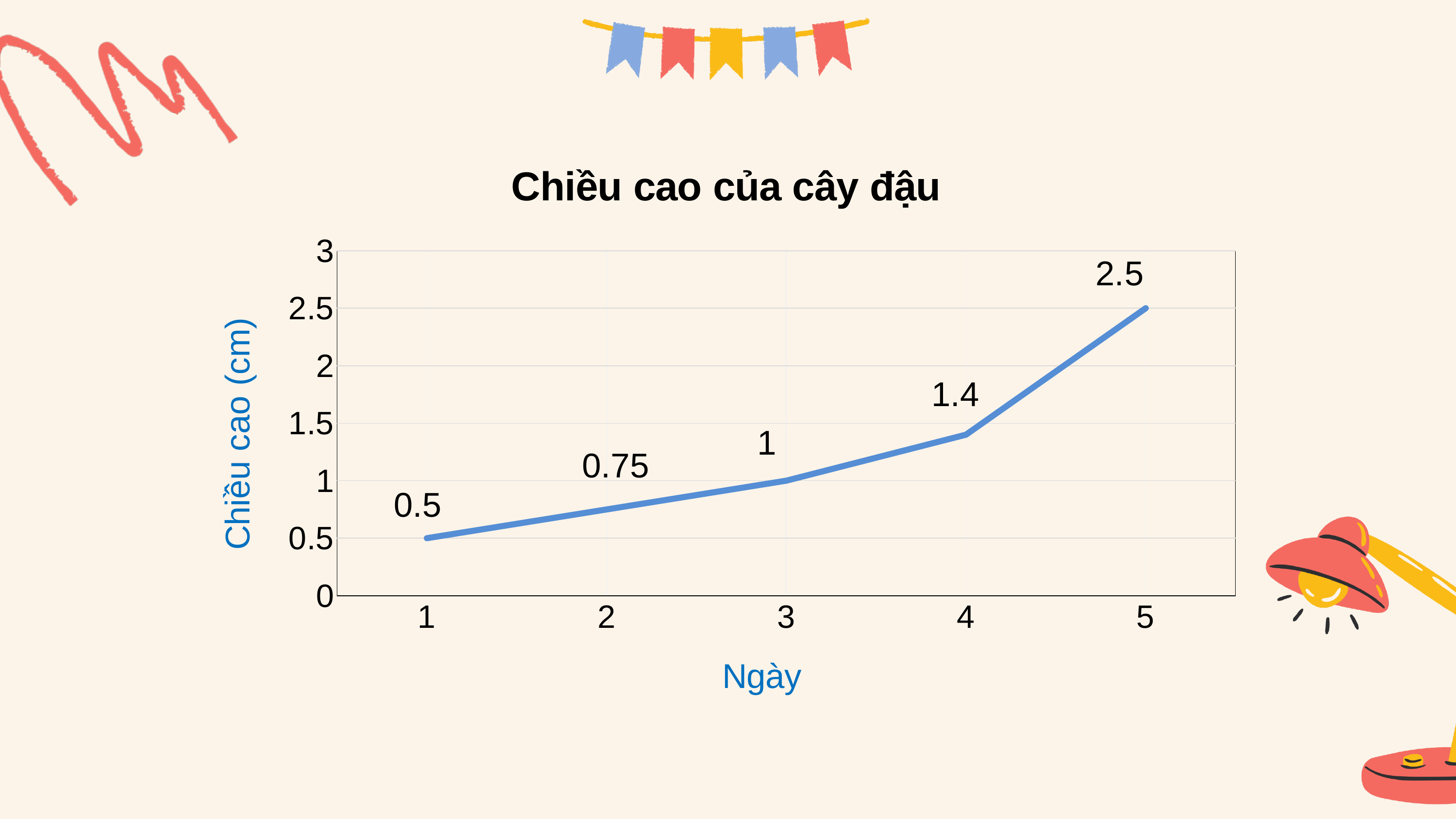
What is the difference in height between day 4 and day 1? 0.9 What is the height of the bean plant on day 3? 1 What is the difference in height between day 5 and day 4? 1.1 What is the title of the chart? Chiều cao của cây đậu What kind of chart is shown on the slide? line chart What is the height of the bean plant on day 2? 0.75 On which day is the plant height the lowest? 1 What is the height of the bean plant on day 5? 2.5 How many days are plotted on the chart? 5 Does the plant height rise or fall from day 1 to day 5? rise On which day is the plant height the highest? 5 Which is larger, the height on day 2 or the height on day 4? day 4